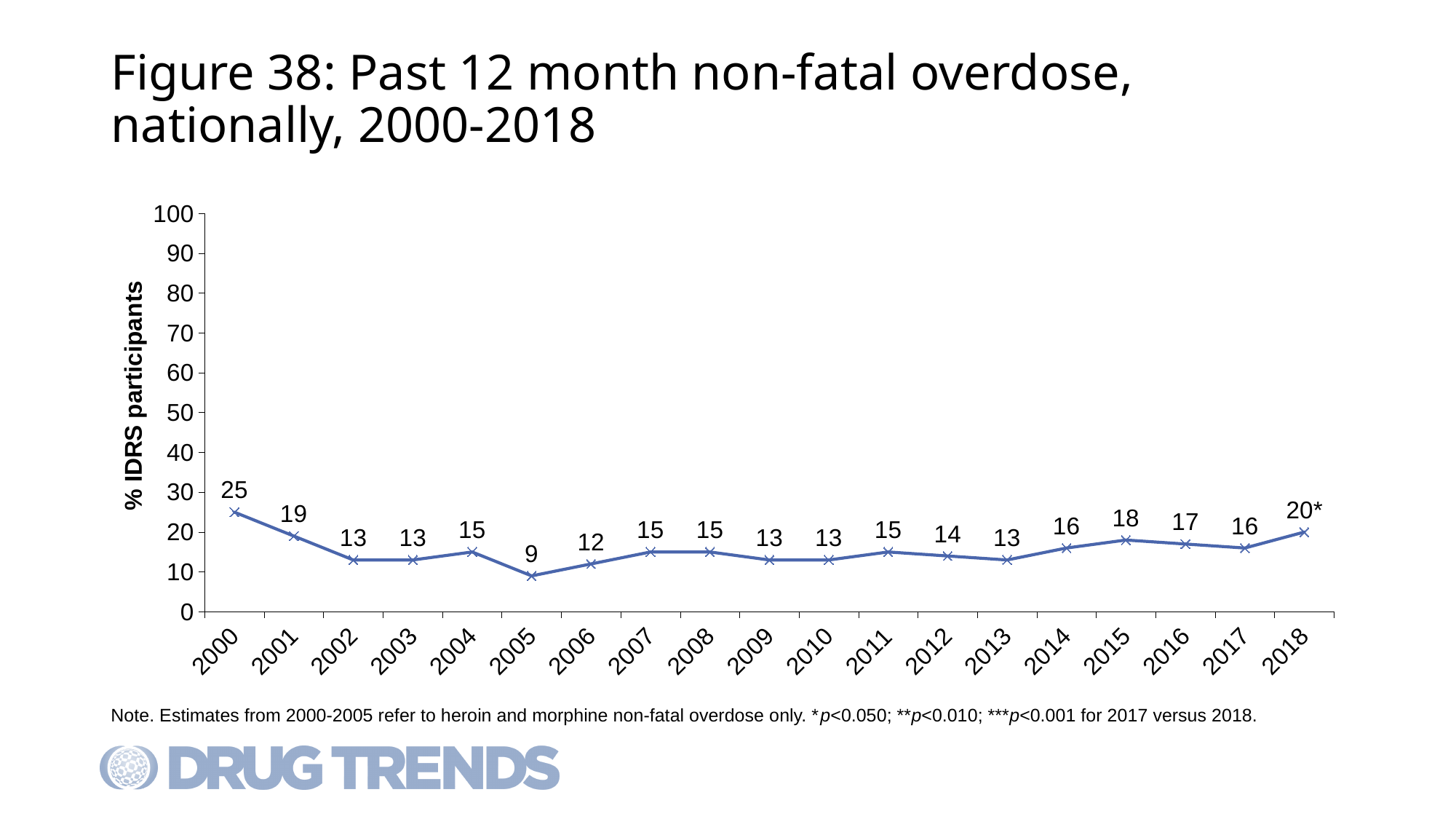
What is the difference between the values for 2000 and 2001? 6 What is the value for 2000? 25 What kind of chart is shown? line chart How many years are plotted on the x axis? 19 Which is larger, the value for 2004 or the value for 2006? 2004 What is the value for 2015? 18 What is the label of the y axis? % IDRS participants What is the data label shown for 2018? 20* Is the value for 2000 greater or less than 20? greater Which year has the lowest value? 2005 What is the value for 2005? 9 Which year has the highest value? 2000